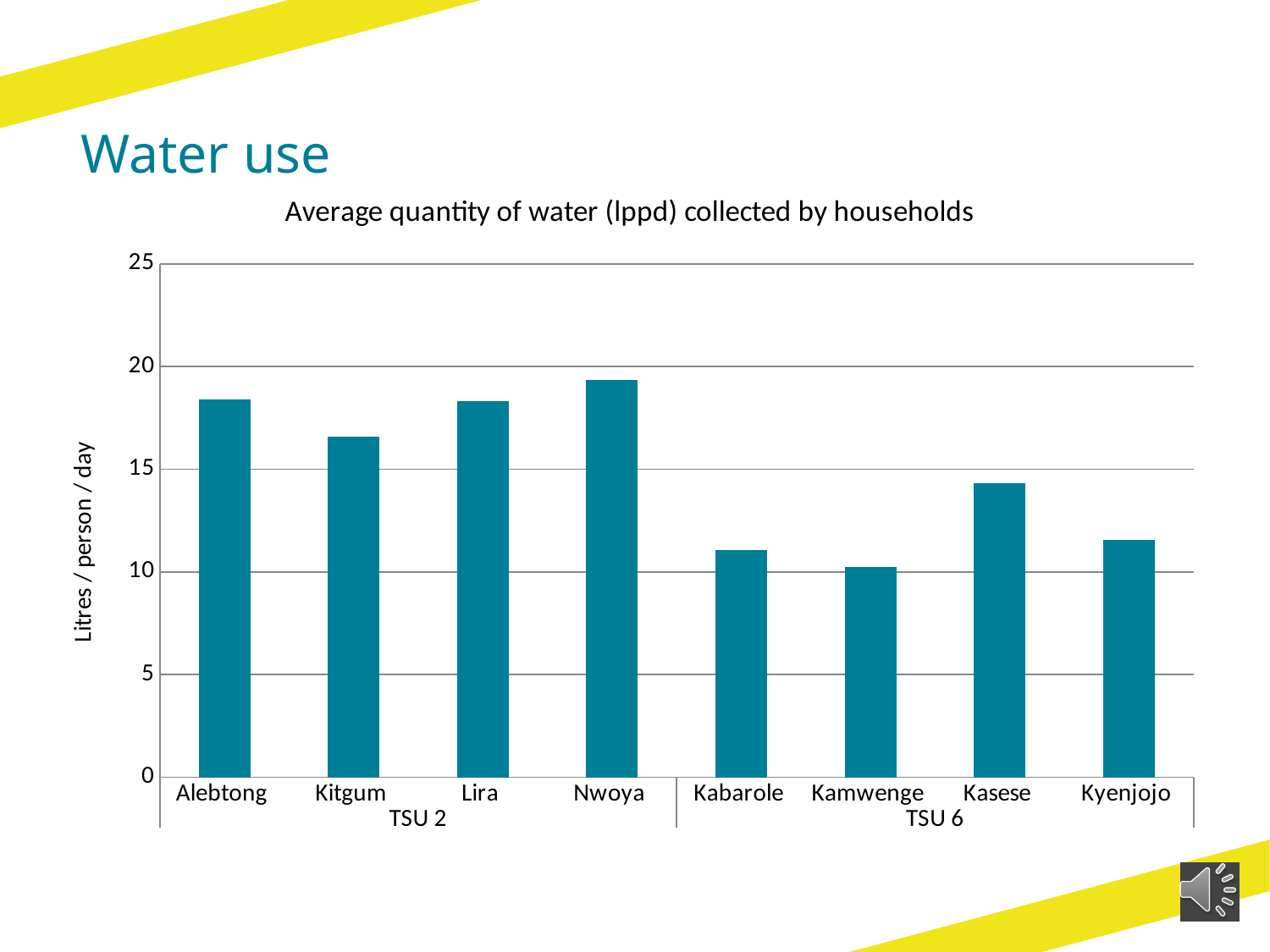
What is the title of the chart? Average quantity of water (lppd) collected by households Is the value for Nwoya greater or less than 20? less Which district has the lowest average quantity of water collected? Kamwenge Which is larger, the value for Kitgum or the value for Kasese? Kitgum How many districts (categories) are plotted on the chart? 8 Is the value for Kasese greater or less than 15? less Is the value for Kyenjojo greater or less than 10? greater What kind of chart is shown on the slide? bar chart What is the label on the vertical axis of the chart? Litres / person / day Which district has the highest average quantity of water collected? Nwoya Which is larger, the value for Nwoya or the value for Kabarole? Nwoya